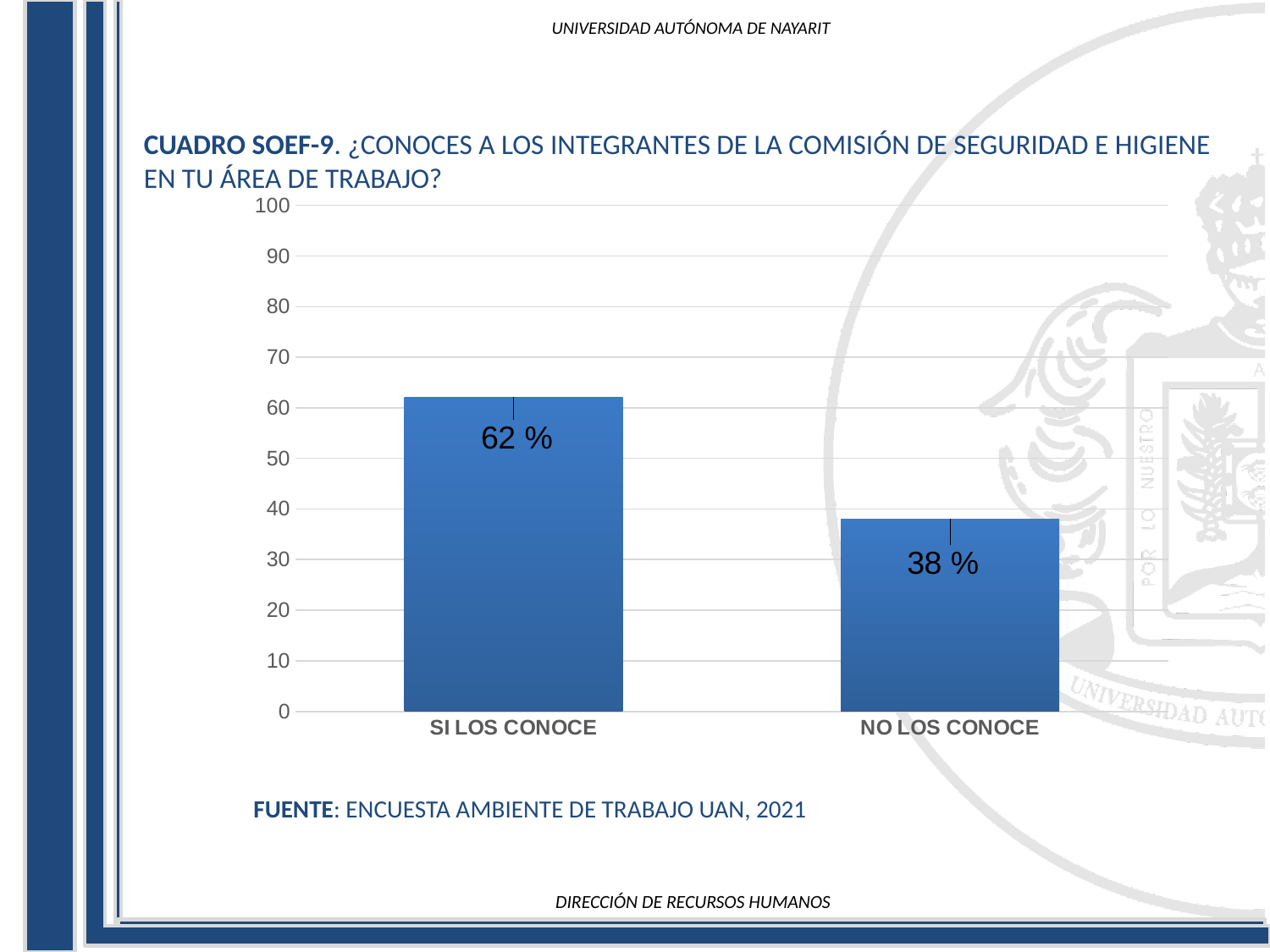
What is the value for NO LOS CONOCE? 38 % What kind of chart is shown on the slide? bar chart Is the value for SI LOS CONOCE greater or less than 60? greater What is the difference between the values for SI LOS CONOCE and NO LOS CONOCE? 24 % Is the value for NO LOS CONOCE greater or less than 50? less How many categories are shown on the x axis? 2 Which category has the lowest value? NO LOS CONOCE Which is larger, the value for SI LOS CONOCE or the value for NO LOS CONOCE? SI LOS CONOCE What is the highest value shown on the y axis? 100 What is the value for SI LOS CONOCE? 62 % What source is cited below the chart? ENCUESTA AMBIENTE DE TRABAJO UAN, 2021 Which category has the highest value? SI LOS CONOCE